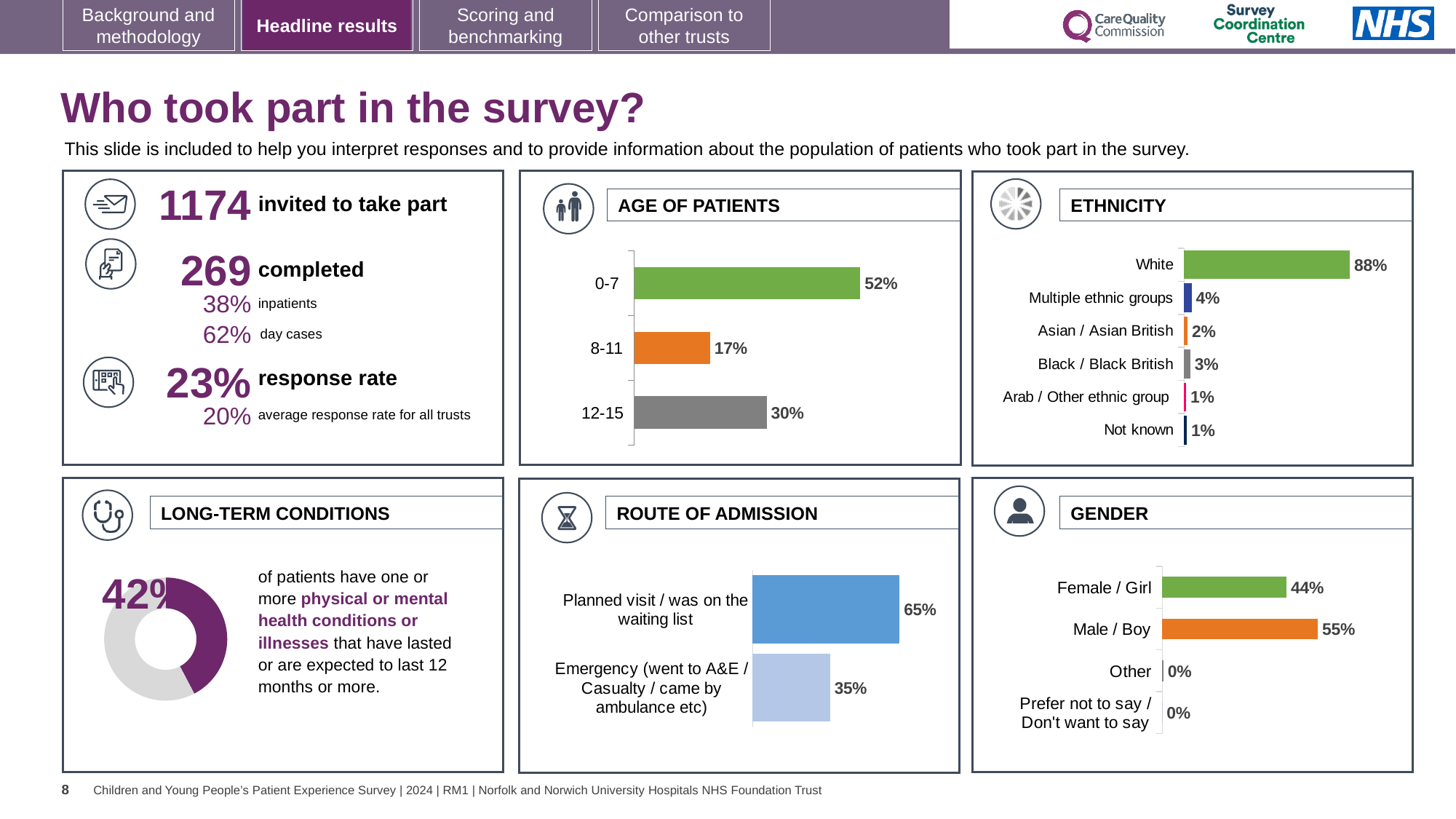
In the LONG-TERM CONDITIONS chart, what percentage of patients have one or more long-term conditions? 42% In the ETHNICITY chart, what is the value for Multiple ethnic groups? 4% In the AGE OF PATIENTS chart, what is the value for the 0-7 age group? 52% In the ETHNICITY chart, which is larger: Black / Black British or Asian / Asian British? Black / Black British In the ROUTE OF ADMISSION chart, what is the value for Emergency (went to A&E / Casualty / came by ambulance etc)? 35% What kind of chart is the ROUTE OF ADMISSION chart? Bar chart In the AGE OF PATIENTS chart, what is the difference between the 0-7 and 12-15 values? 22% In the GENDER chart, what is the value for Male / Boy? 55% In the ETHNICITY chart, which category has the highest value? White How many categories are shown in the ETHNICITY chart? 6 In the GENDER chart, what is the difference between Male / Boy and Female / Girl? 11% In the AGE OF PATIENTS chart, which age group has the lowest value? 8-11